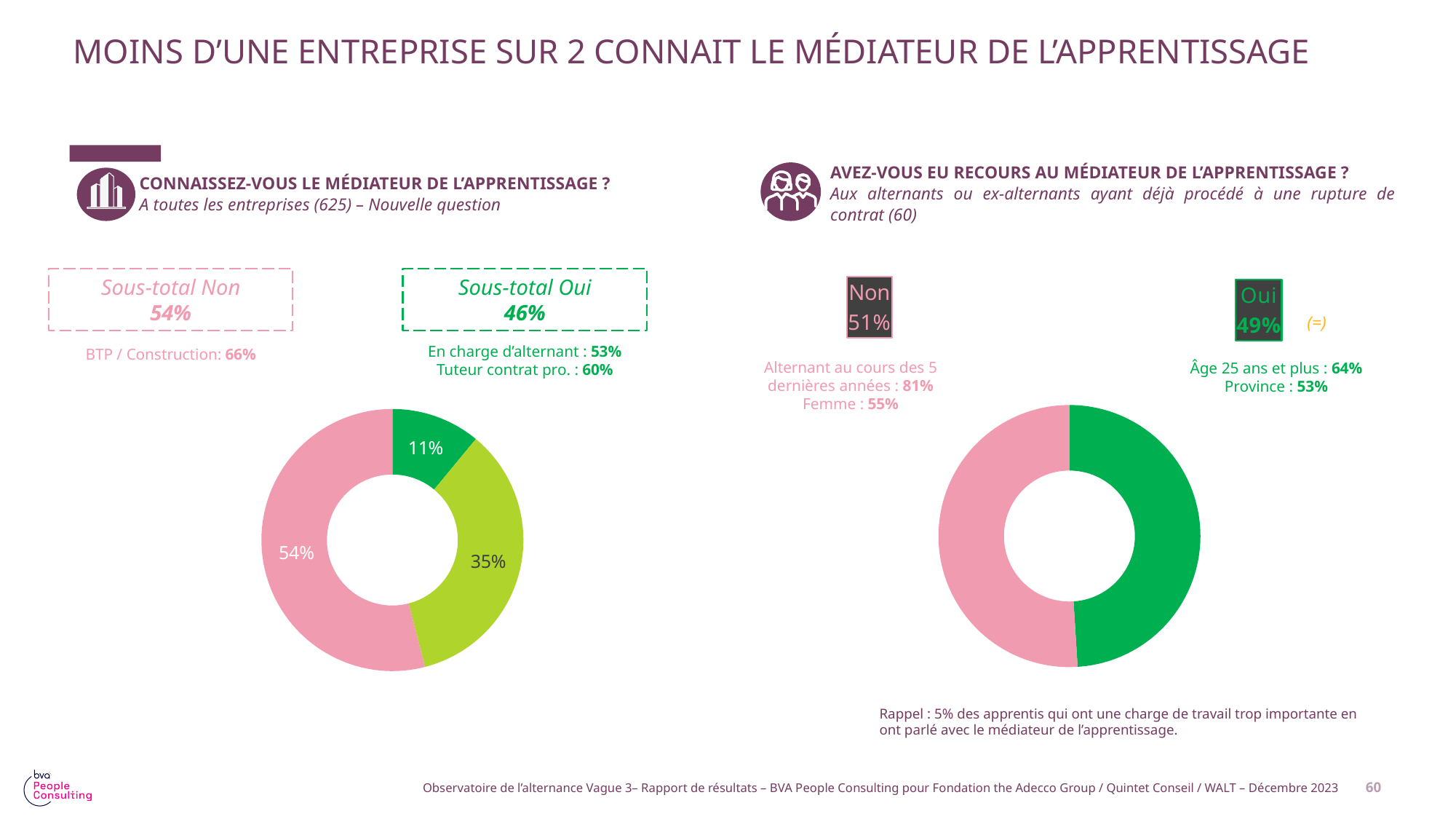
What kind of chart is used on the left side of the slide, under "Connaissez-vous le médiateur de l'apprentissage ?"? Donut (pie) chart On the left side of the slide, what is the "Sous-total Non" value? 54% In the left donut chart (Connaissez-vous le médiateur de l'apprentissage ?), what is the combined share of the two green slices (11% and 35%)? 46% In the left donut chart (Connaissez-vous le médiateur de l'apprentissage ?), what is the difference between the 54% slice and the 35% slice? 19 points In the left donut chart (Connaissez-vous le médiateur de l'apprentissage ?), what is the value of the smallest slice? 11% In the left donut chart (Connaissez-vous le médiateur de l'apprentissage ?), how many slices are there? 3 In the left donut chart (Connaissez-vous le médiateur de l'apprentissage ?), what is the value of the largest slice? 54% In the right donut chart (Avez-vous eu recours au médiateur de l'apprentissage ?), which is larger, "Oui" or "Non"? Non On the left side of the slide, what is the "Sous-total Oui" value? 46% In the right donut chart (Avez-vous eu recours au médiateur de l'apprentissage ?), what is the value for "Non"? 51% In the left donut chart (Connaissez-vous le médiateur de l'apprentissage ?), what is the value of the light green slice? 35% In the right donut chart (Avez-vous eu recours au médiateur de l'apprentissage ?), what is the difference between "Non" and "Oui"? 2 points